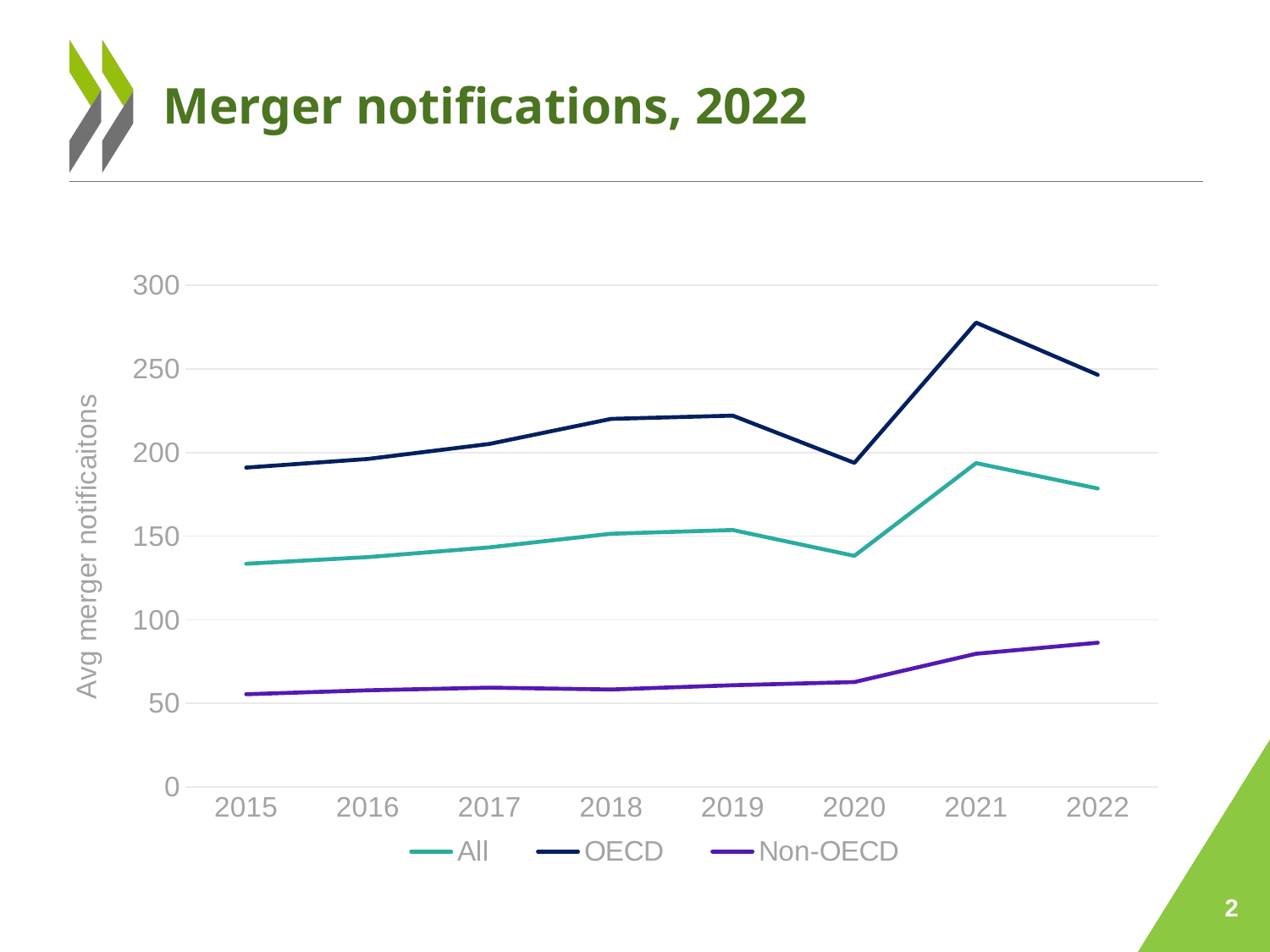
In which year does the OECD series reach its highest value? 2021 How many series does the legend list? 3 In which year does the Non-OECD series reach its highest value? 2022 Is the value for All in 2020 greater or less than 150? less Which series has the larger value in 2022, OECD or Non-OECD? OECD Is the value for OECD in 2015 greater or less than 200? less Is the value for OECD in 2021 greater or less than 250? greater In which year does the All series reach its highest value? 2021 What is the title of the slide? Merger notifications, 2022 How many years are plotted along the x axis? 8 What kind of chart is shown on the slide? line chart